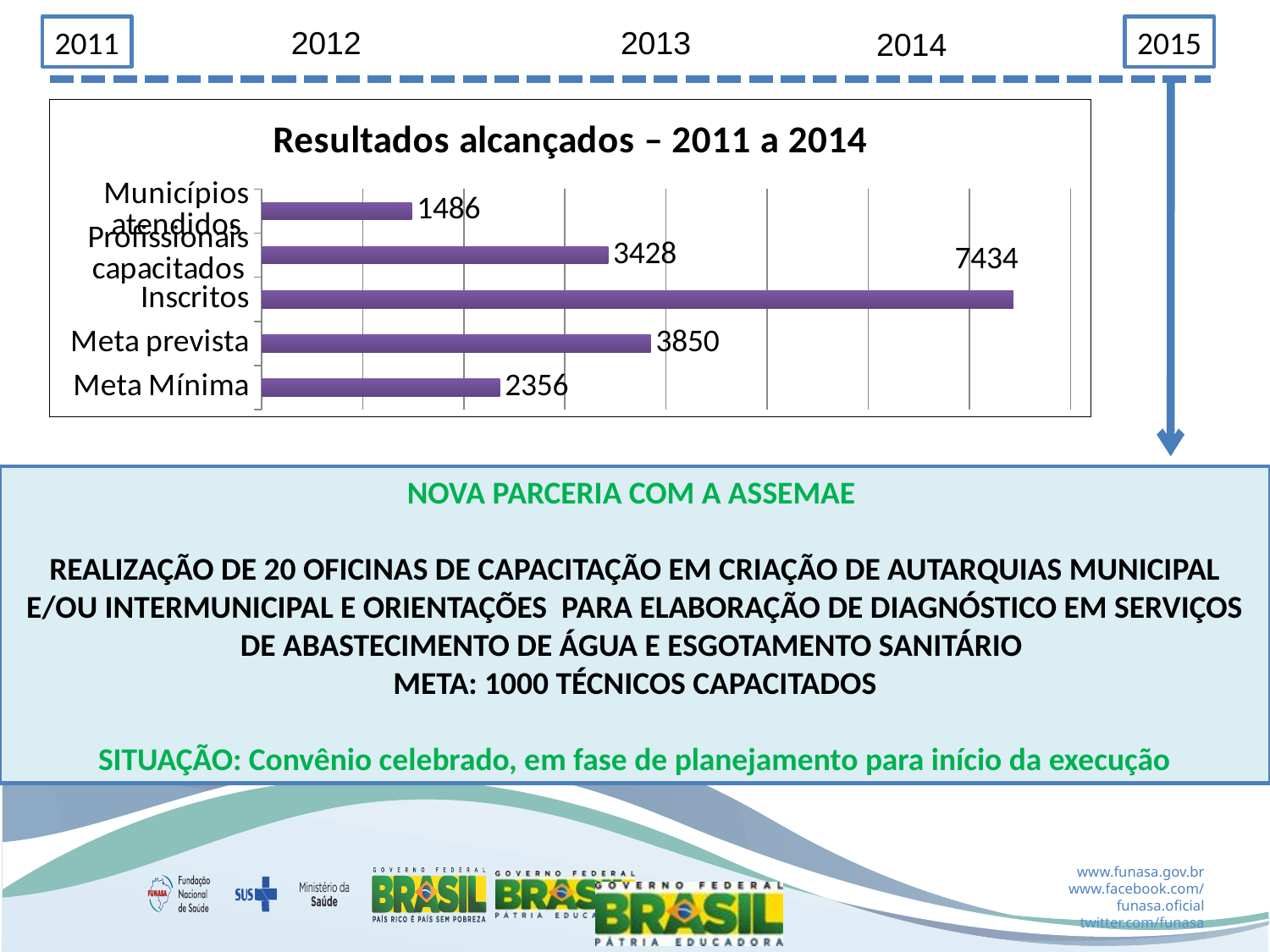
What is the value for "Meta Mínima" in the chart? 2356 Which is larger, the value for "Meta prevista" or the value for "Meta Mínima"? Meta prevista What type of chart is shown under the title "Resultados alcançados – 2011 a 2014"? bar chart What is the difference between the values for "Meta prevista" and "Profissionais capacitados"? 422 How many categories are plotted in the chart? 5 What is the value for "Municípios atendidos" in the chart? 1486 Which category has the lowest value in the chart? Municípios atendidos Which category has the highest value in the chart? Inscritos What is the value for "Meta prevista" in the chart? 3850 What is the difference between the values for "Inscritos" and "Meta Mínima"? 5078 What is the value for "Profissionais capacitados" in the chart? 3428 What is the value for "Inscritos" in the chart? 7434